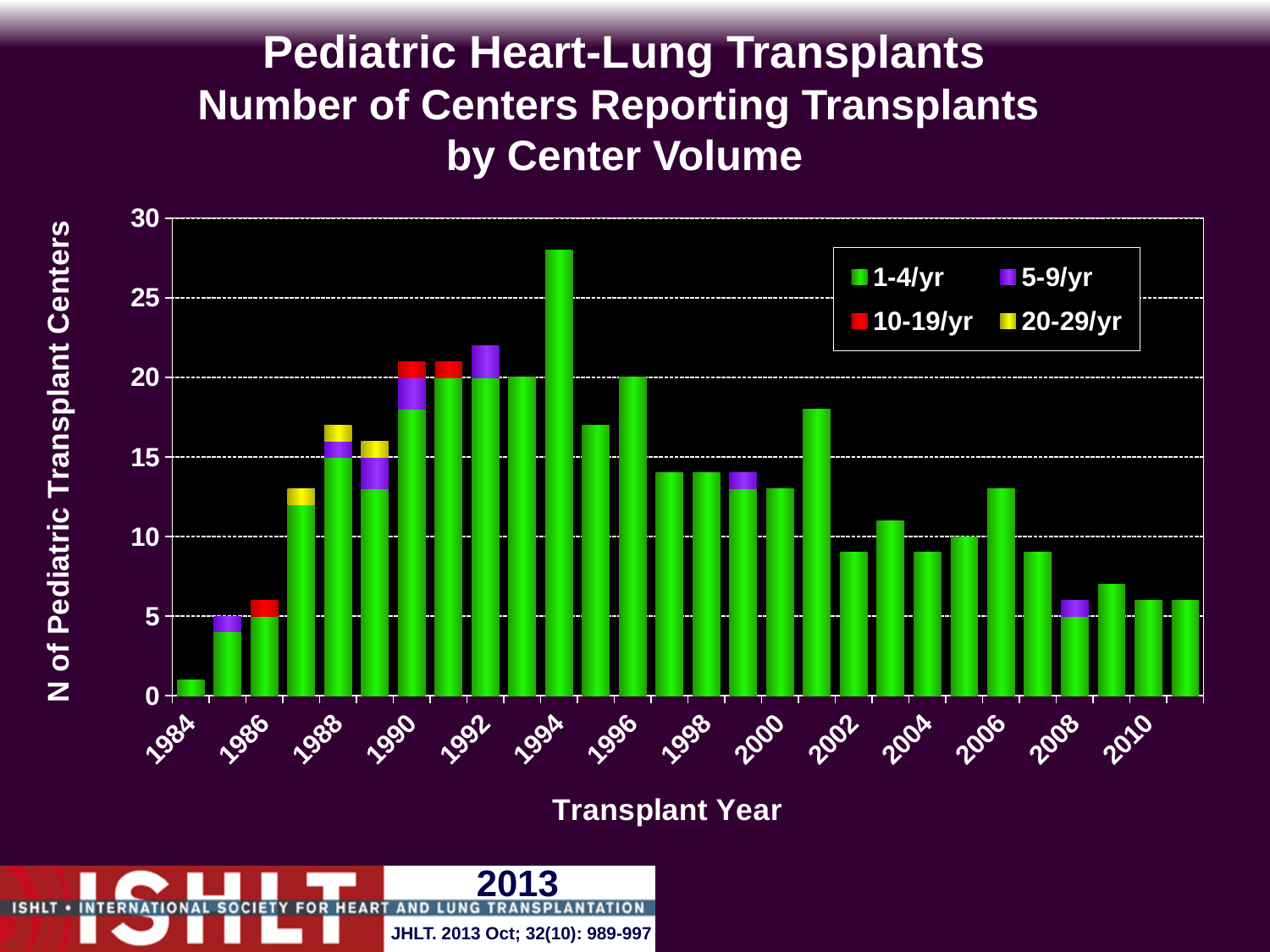
Is the total number of centers for 2002 greater or less than 10? less What kind of chart is shown on the slide? Stacked bar chart Do the total numbers of centers generally rise or fall from 2001 to 2011? fall Which year has more reporting centers, 2001 or 2002? 2001 Which transplant year has the lowest number of pediatric transplant centers? 1984 Is the total number of centers for 1990 greater or less than 20? greater How many series does the legend list? 4 Which year has more reporting centers, 1994 or 1996? 1994 Which legend entry is shown in green? 1-4/yr Is the total number of centers for 1994 greater or less than 25? greater Which transplant year has the highest number of pediatric transplant centers? 1994